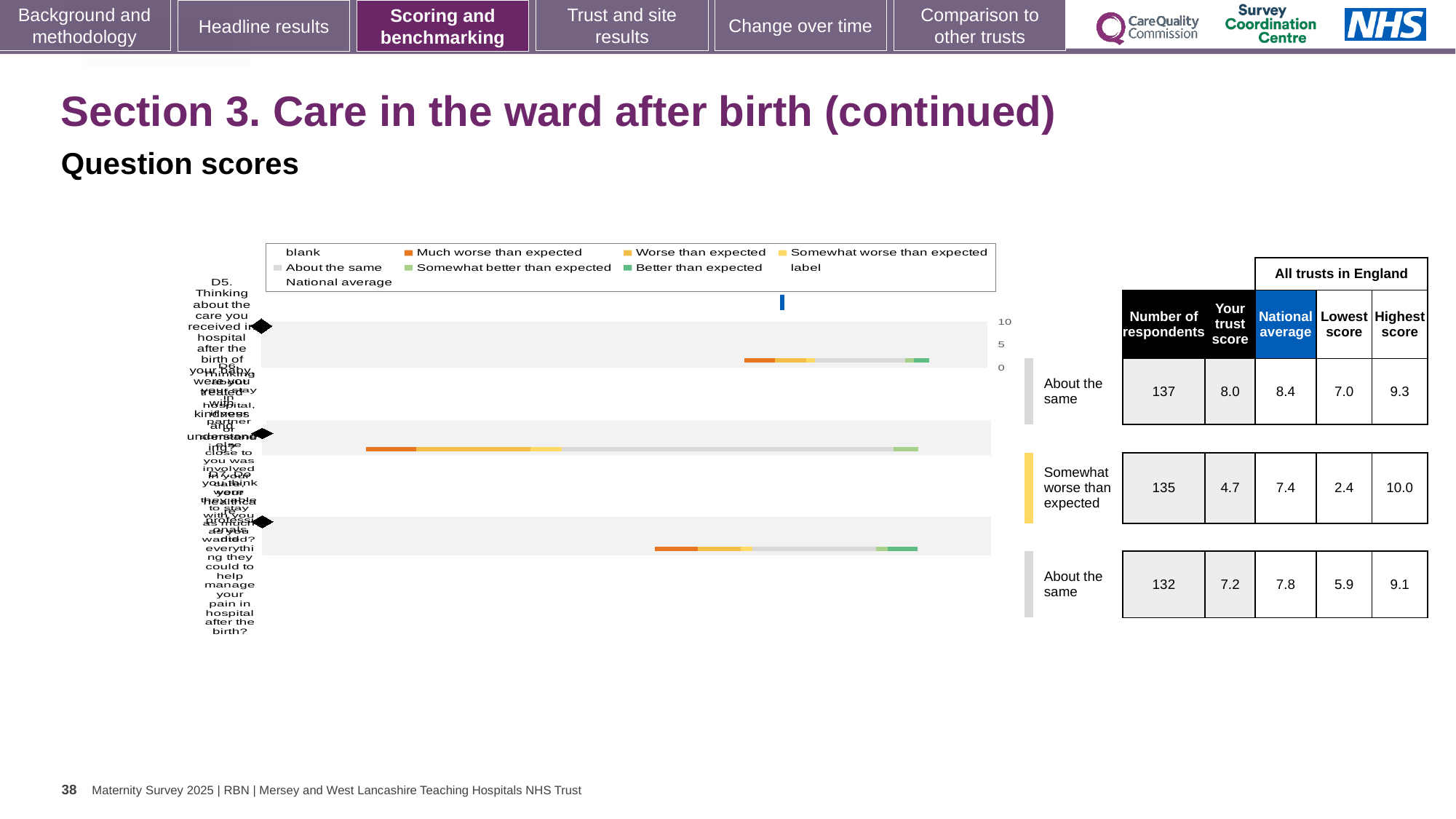
What is the number of respondents for the bottom row of the chart? 132 What is the 'Your trust score' for the top row of the chart (the question rated 'About the same' with 137 respondents)? 8.0 Which row of the chart has the highest 'Your trust score'? the top row (About the same), 8.0 What is the difference between the national average and the trust score for the middle row (rated 'Somewhat worse than expected')? 2.7 What is the highest score among all trusts in England for the middle row (rated 'Somewhat worse than expected')? 10.0 How many question rows (bars) are plotted in the chart? 3 What is the national average for the middle row of the chart (the question rated 'Somewhat worse than expected')? 7.4 What kind of chart is shown on the slide? bar chart What is the lowest score among all trusts in England for the bottom row of the chart? 5.9 Which row of the chart has the lowest 'Your trust score'? the middle row (Somewhat worse than expected), 4.7 Is the trust score for the top row or the bottom row of the chart larger? the top row (8.0)